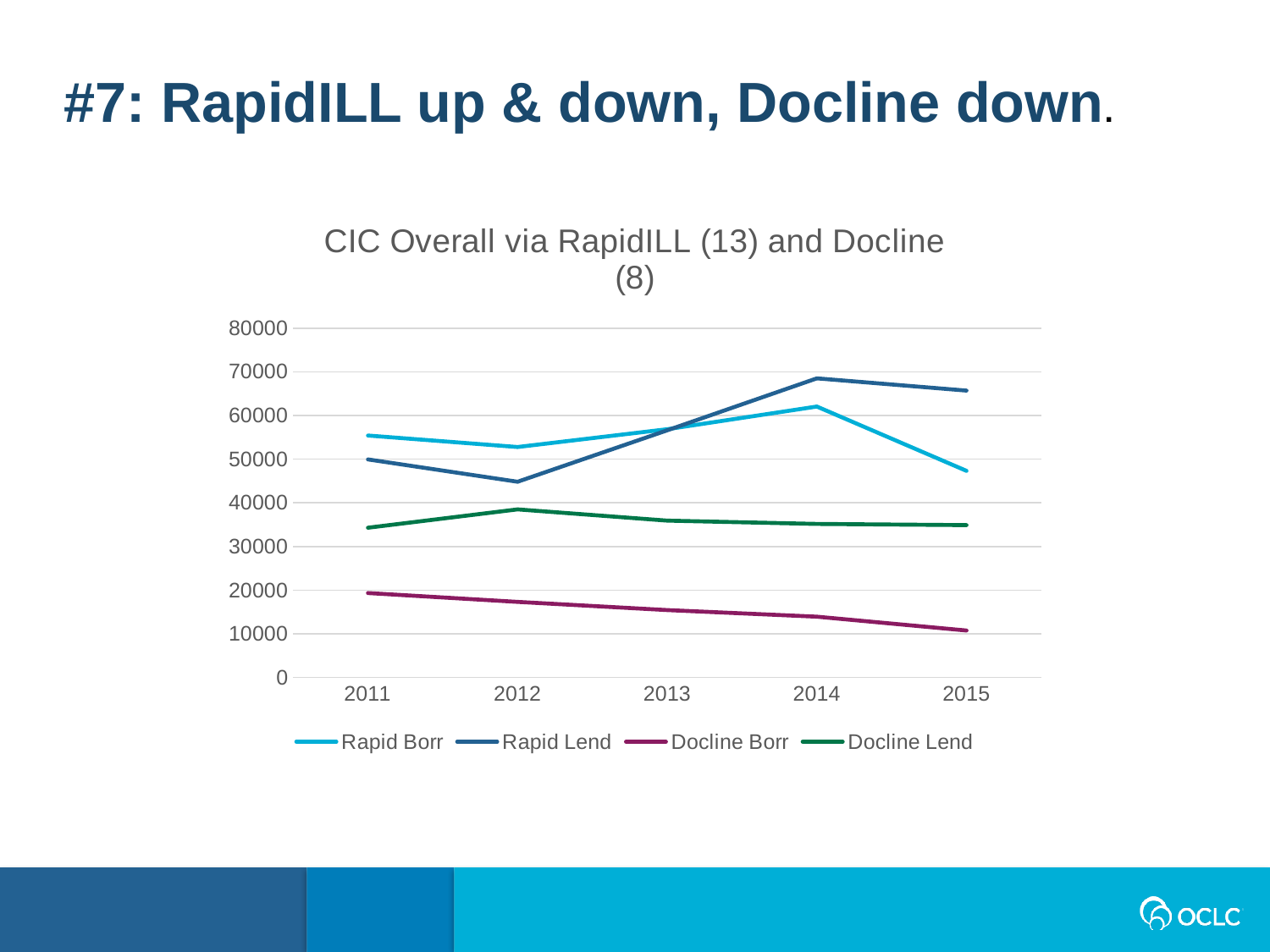
Does the Docline Borr series rise or fall from 2011 to 2015? fall How many series does the legend list? 4 In which year is Rapid Lend at its highest? 2014 Is the value for Docline Lend in 2012 greater or less than 30000? greater In which year is Docline Borr at its lowest? 2015 In which year is Rapid Borr at its lowest? 2015 In 2015, which is larger: Rapid Lend or Rapid Borr? Rapid Lend Is the value for Rapid Lend in 2014 greater or less than 60000? greater What is the title of the chart? CIC Overall via RapidILL (13) and Docline (8) Is the value for Docline Borr in 2015 greater or less than 20000? less How many years are shown on the x axis? 5 What kind of chart is shown on the slide? line chart